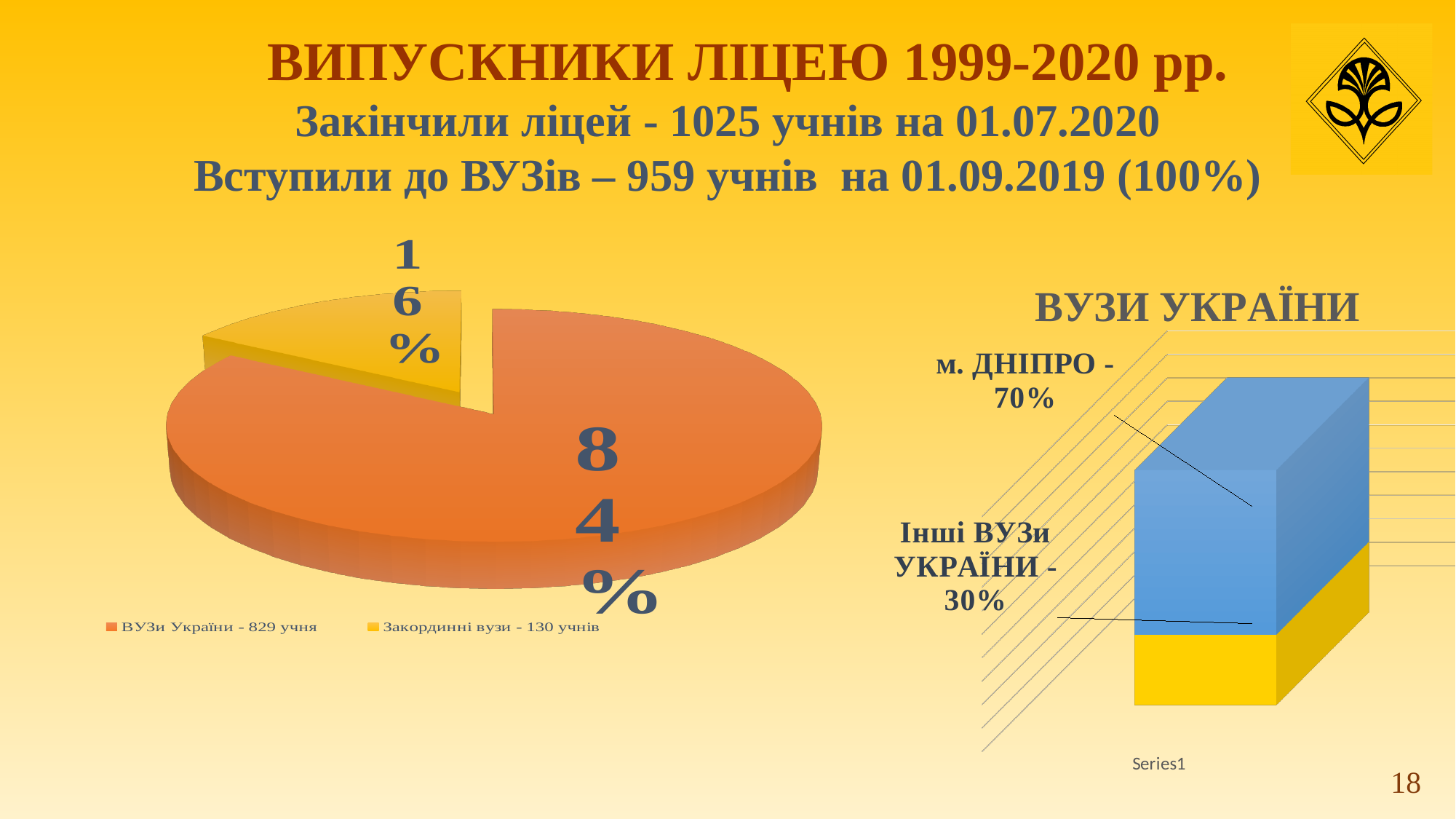
In the pie chart on the left, which slice is the smallest? Закординні вузи - 130 учнів In the pie chart on the left, what share is shown for the slice "ВУЗи України - 829 учня"? 84% In the pie chart on the left, what is the difference in percentage points between the two slices? 68 In the chart titled "ВУЗИ УКРАЇНИ", which segment is larger, "м. ДНІПРО" or "Інші ВУЗи УКРАЇНИ"? м. ДНІПРО In the pie chart on the left, what share is shown for the slice "Закординні вузи - 130 учнів"? 16% In the pie chart on the left, how many slices are there? 2 In the chart titled "ВУЗИ УКРАЇНИ", what value is shown for "Інші ВУЗи УКРАЇНИ"? 30% In the chart titled "ВУЗИ УКРАЇНИ", what value is shown for "м. ДНІПРО"? 70% In the pie chart on the left, which slice is the largest? ВУЗи України - 829 учня What kind of chart is the chart titled "ВУЗИ УКРАЇНИ" on the right of the slide? bar chart In the chart titled "ВУЗИ УКРАЇНИ", what is the total of the stacked bar? 100% What kind of chart is the chart on the left of the slide? pie chart